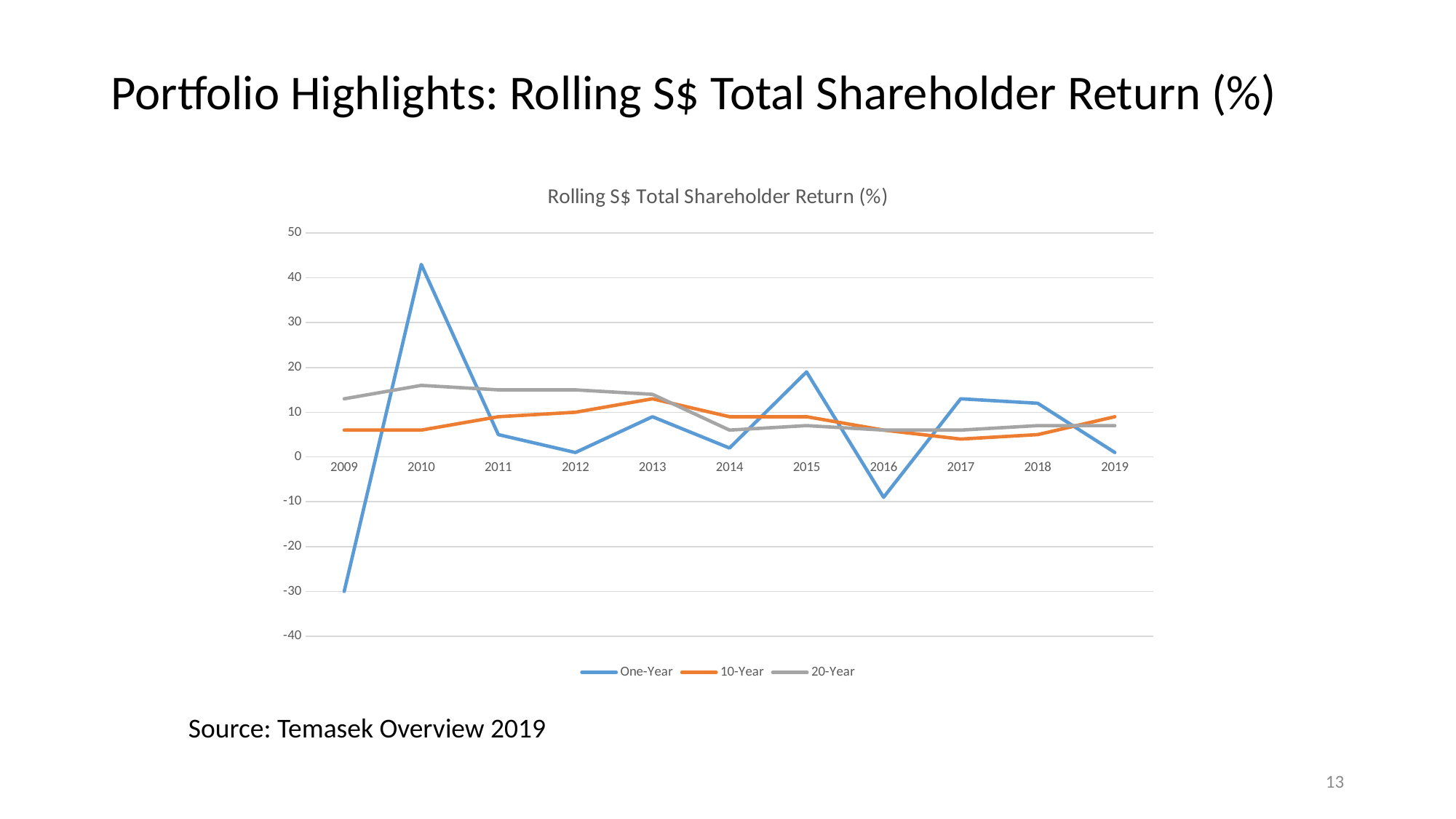
How many series does the legend list? 3 Is the 20-Year value for 2010 greater or less than 10? greater In which year does the One-Year series reach its lowest value? 2009 Is the One-Year value for 2016 greater or less than 0? less In which year does the One-Year series reach its highest value? 2010 In 2016, which is larger: the One-Year value or the 20-Year value? 20-Year What is the One-Year value in 2009? -30 Is the One-Year value for 2010 greater or less than 40? greater Which series is drawn in orange? 10-Year In 2010, which is larger: the One-Year value or the 20-Year value? One-Year What kind of chart is shown on the slide? line chart How many years are plotted along the x axis? 11